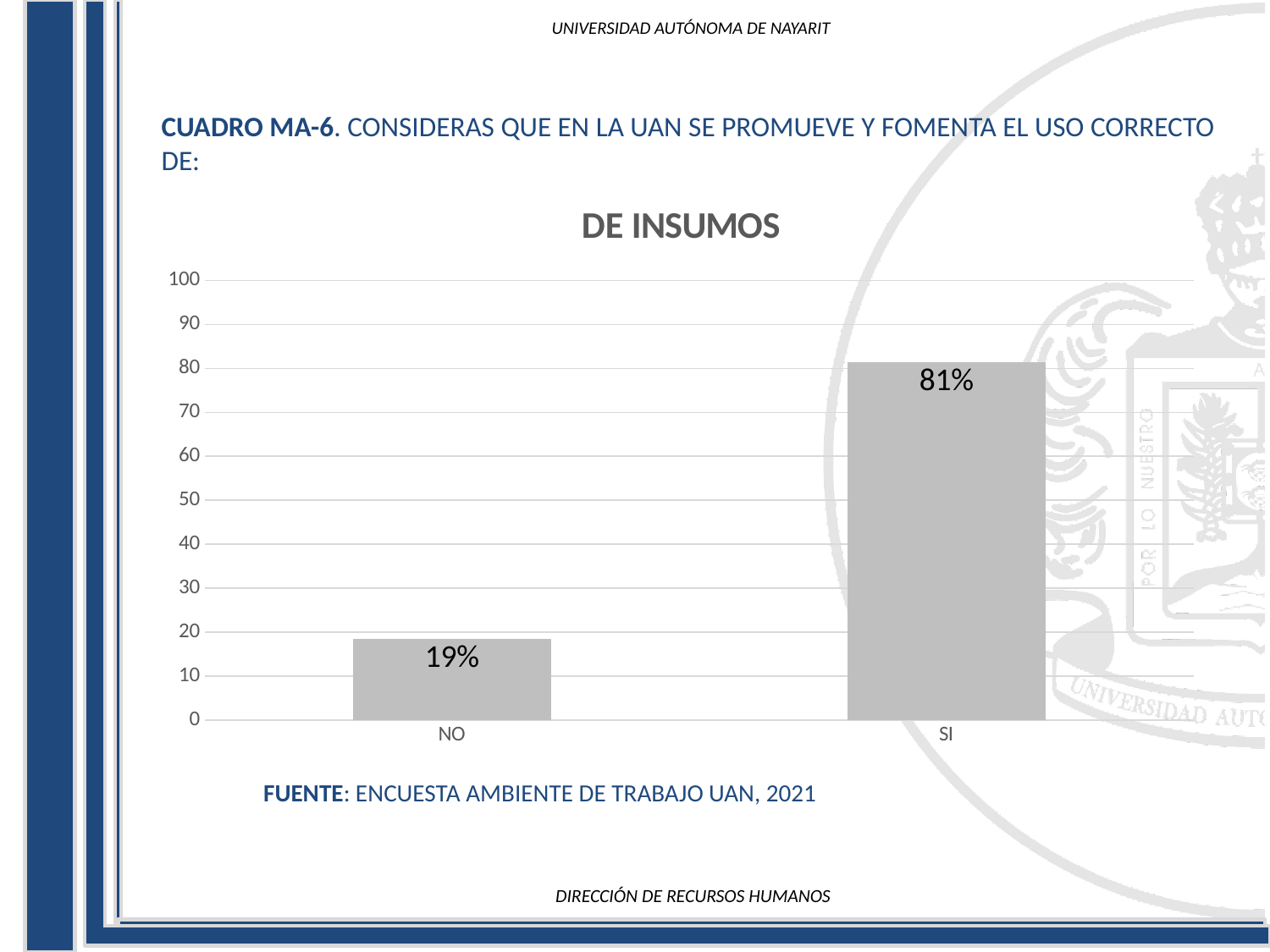
Is the value for SI greater or less than 70? greater How many categories are shown on the x axis? 2 Which is larger, the value for NO or the value for SI? SI Which category has the lowest value? NO Is the value for NO greater or less than 30? less What is the value for NO? 19% What is the maximum value shown on the y axis? 100 Which category has the highest value? SI What is the difference between the values for SI and NO? 62% What kind of chart is shown? bar chart What is the value for SI? 81% What is the title of the chart? DE INSUMOS